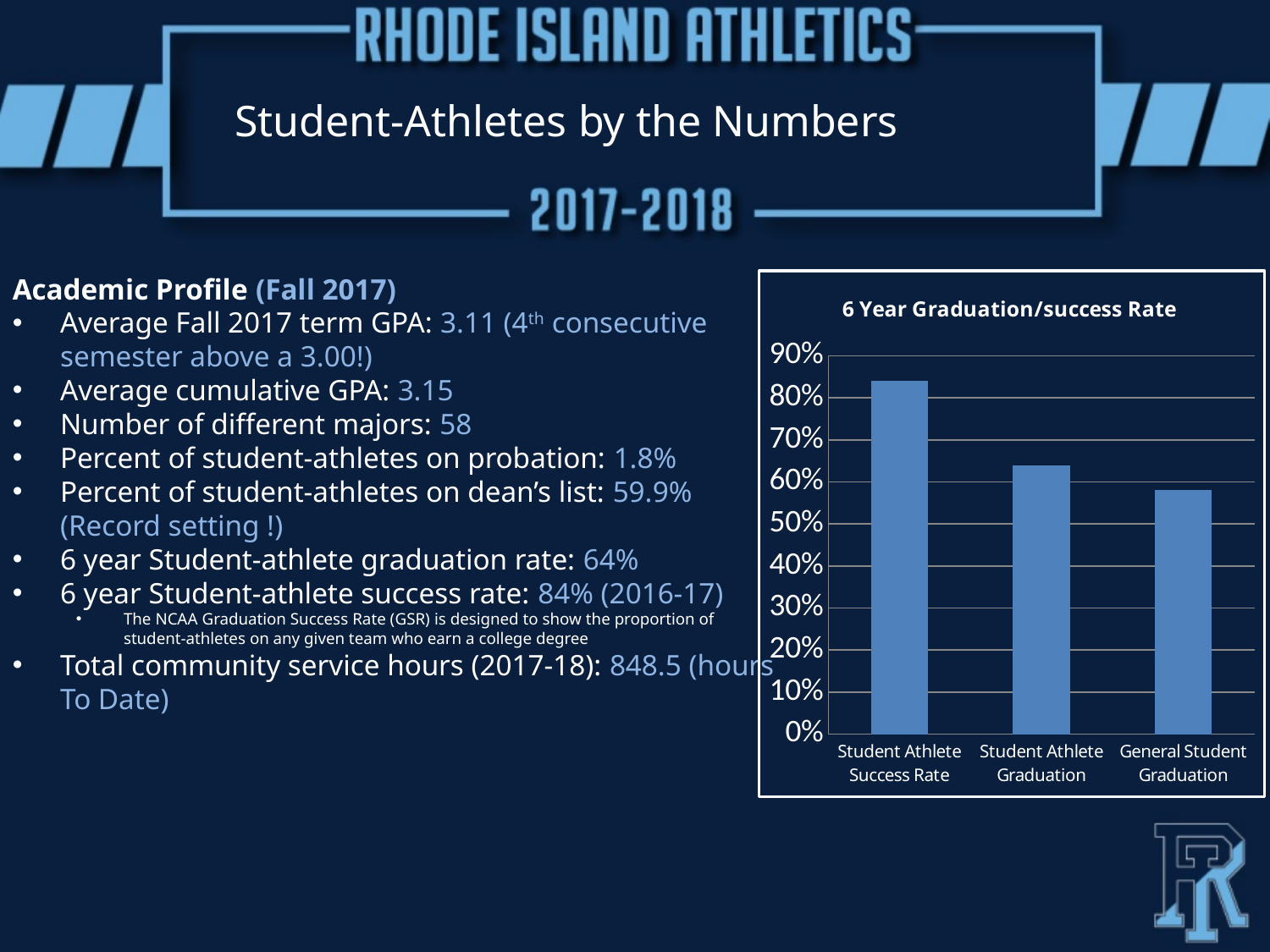
Is the value for Student Athlete Success Rate greater or less than 80%? greater Which category has the lowest value in the chart? General Student Graduation Is the value for Student Athlete Success Rate greater or less than 90%? less Is the value for Student Athlete Graduation greater or less than 60%? greater What kind of chart is shown on the slide? bar chart What is the title of the chart? 6 Year Graduation/success Rate Which category has the highest value in the chart? Student Athlete Success Rate Do the values rise or fall from left to right across the categories? fall How many categories are plotted in the chart? 3 What is the highest value shown on the vertical axis of the chart? 90% Which is larger, Student Athlete Graduation or General Student Graduation? Student Athlete Graduation